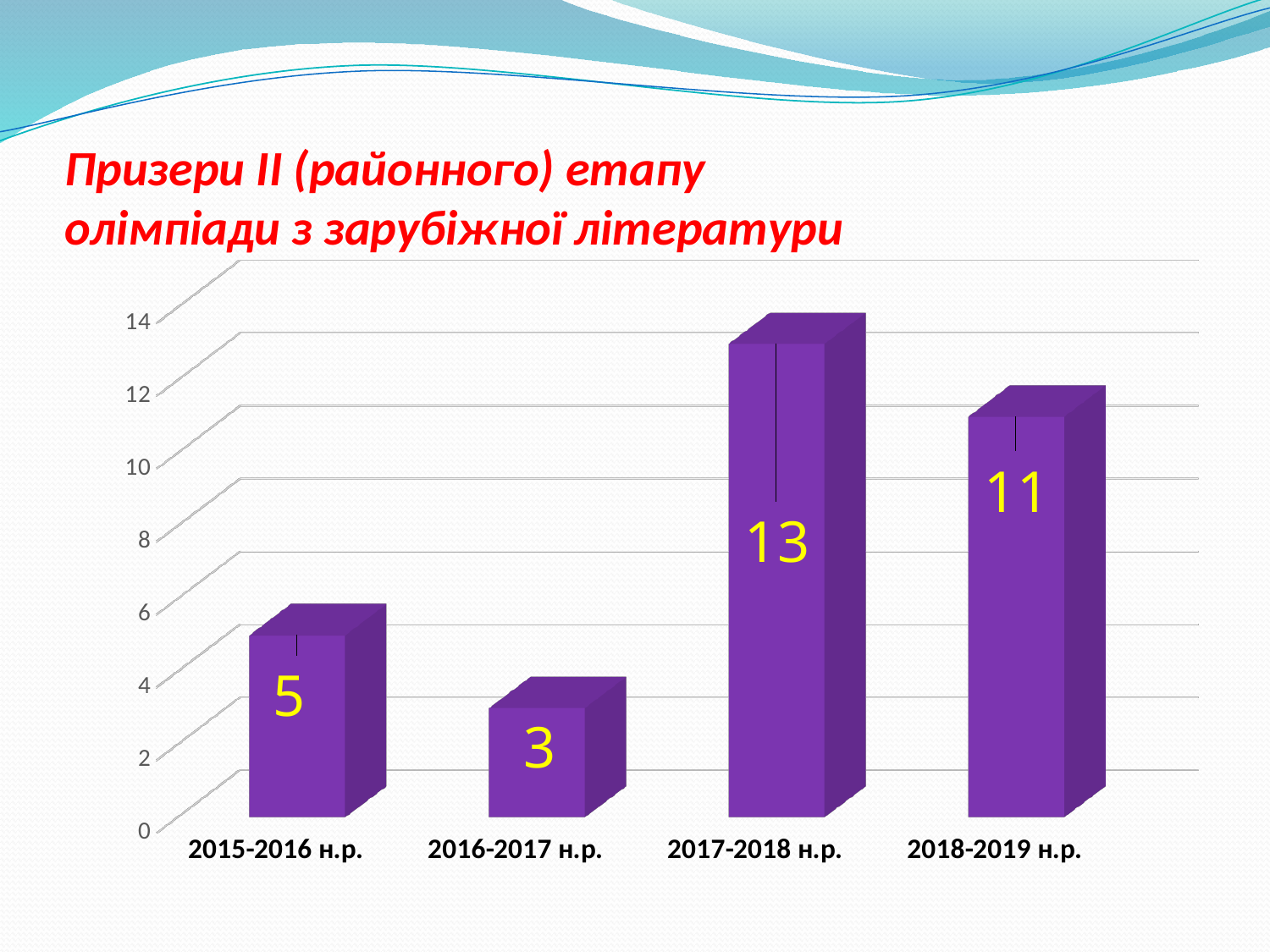
Which is larger, the value for 2015-2016 н.р. or 2016-2017 н.р.? 2015-2016 н.р. What is the difference between the values for 2015-2016 н.р. and 2016-2017 н.р.? 2 How many categories are shown on the x axis? 4 What is the title of the slide above the chart? Призери ІІ (районного) етапу олімпіади з зарубіжної літератури What is the value for 2017-2018 н.р.? 13 What is the value for 2018-2019 н.р.? 11 What kind of chart is shown on the slide? bar chart What is the value for 2016-2017 н.р.? 3 What is the value for 2015-2016 н.р.? 5 What is the difference between the values for 2017-2018 н.р. and 2018-2019 н.р.? 2 Which year has the highest value? 2017-2018 н.р. Which year has the lowest value? 2016-2017 н.р.